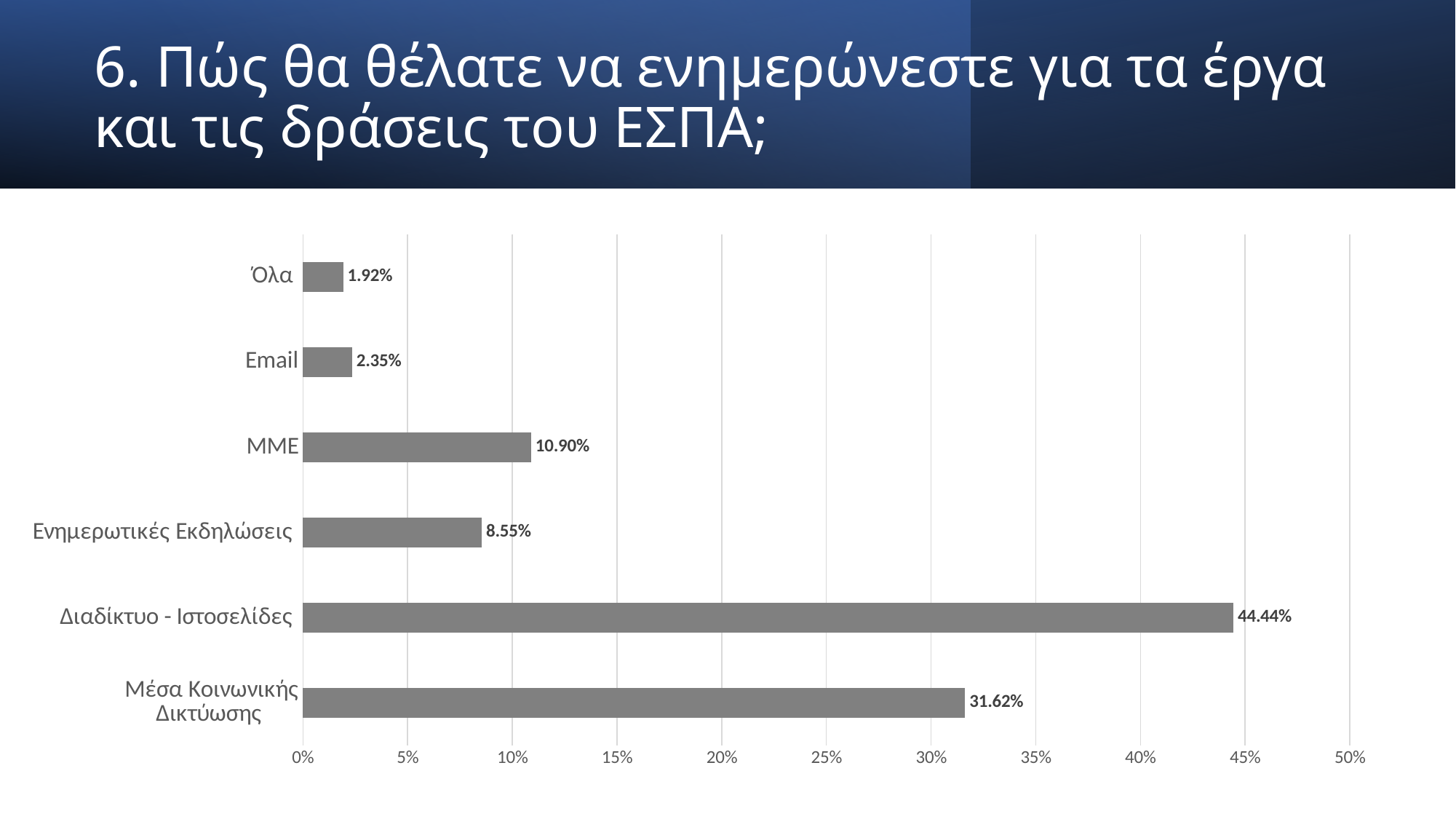
How many categories are shown in the chart? 6 What is the maximum value shown on the horizontal axis? 50% What is the value for Διαδίκτυο - Ιστοσελίδες? 44.44% What is the value for Μέσα Κοινωνικής Δικτύωσης? 31.62% Is the value for Μέσα Κοινωνικής Δικτύωσης greater or less than 30%? greater Which category has the highest value? Διαδίκτυο - Ιστοσελίδες What kind of chart is shown on the slide? Bar chart What is the difference between the values for Διαδίκτυο - Ιστοσελίδες and Μέσα Κοινωνικής Δικτύωσης? 12.82% What is the value for Email? 2.35% What is the value for ΜΜΕ? 10.90% Which is larger, the value for ΜΜΕ or the value for Ενημερωτικές Εκδηλώσεις? ΜΜΕ Which category has the lowest value? Όλα